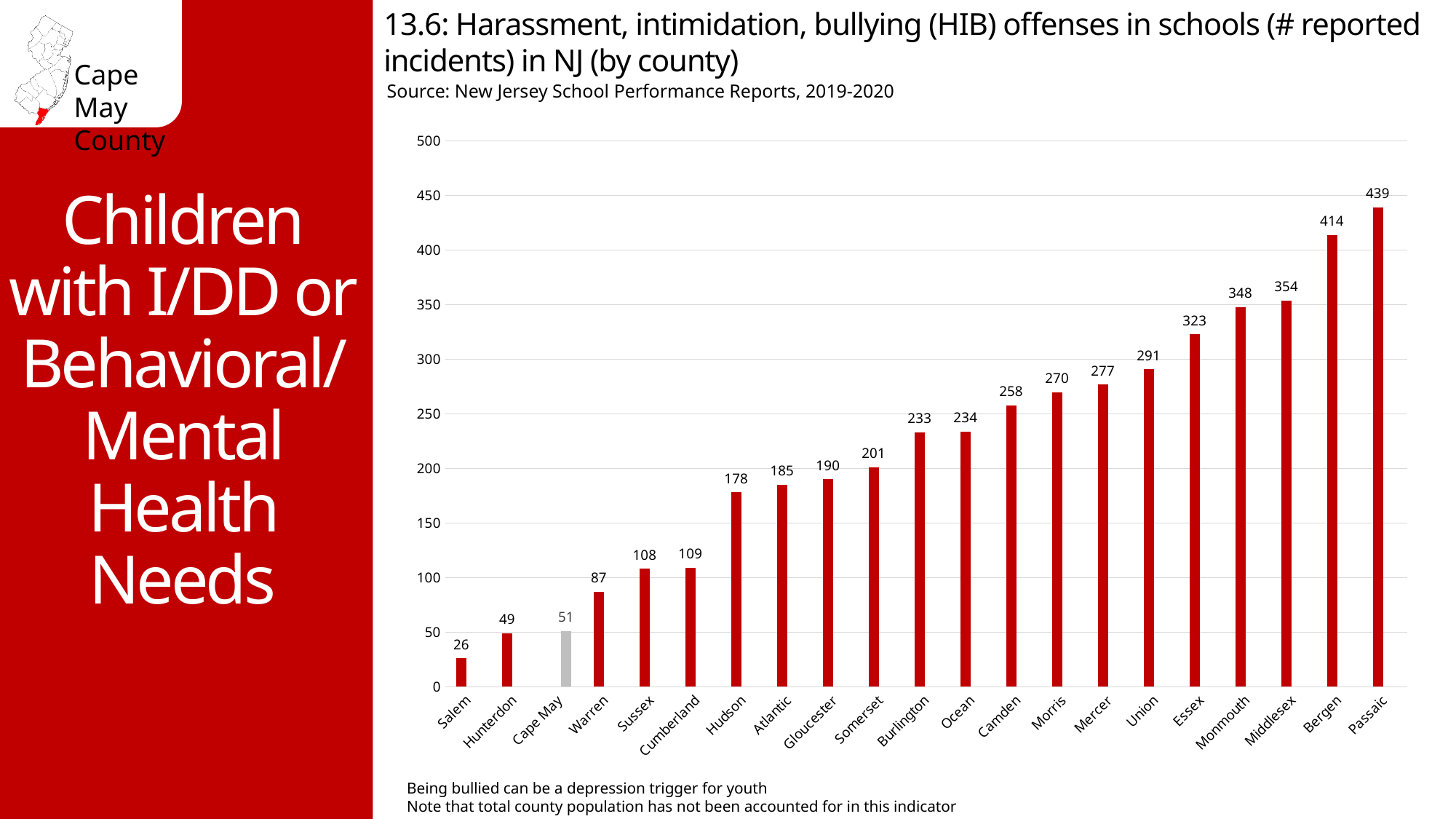
Which county has more reported HIB incidents, Essex or Union? Essex What is the number of reported HIB incidents for Cape May? 51 Which county has the lowest number of reported HIB incidents? Salem What kind of chart is used on this slide? Bar chart Which county has the highest number of reported HIB incidents? Passaic How many counties are shown on the chart? 21 Is the value for Monmouth greater or less than 300? greater What is the number of reported HIB incidents for Bergen? 414 Which county's bar is coloured grey instead of red? Cape May What is the difference in reported HIB incidents between Hudson and Atlantic? 7 Do the values rise or fall moving from left to right along the x axis? Rise What is the difference in reported HIB incidents between Passaic and Salem? 413